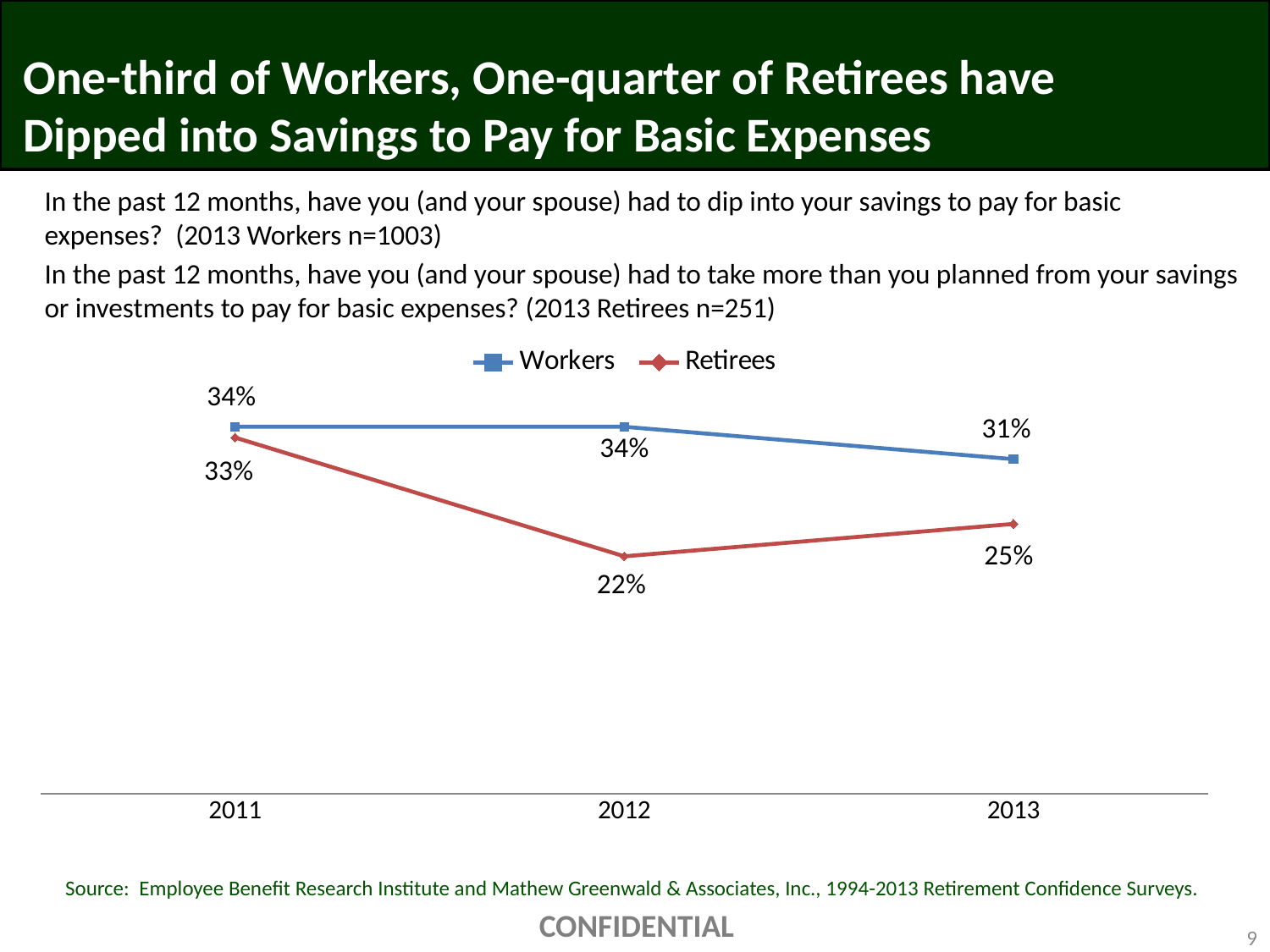
How many series does the legend list? 2 What is the difference between the Workers and Retirees values in 2013? 6% What is the value for Workers in 2011? 34% In which year is the Retirees value lowest? 2012 In which year is the Workers value lowest? 2013 Which series has the larger value in 2013, Workers or Retirees? Workers What is the value for Workers in 2013? 31% What kind of chart is shown on the slide? Line chart What is the difference between the Workers and Retirees values in 2012? 12% What is the value for Retirees in 2012? 22% How many years are shown on the x axis? 3 What is the value for Retirees in 2011? 33%